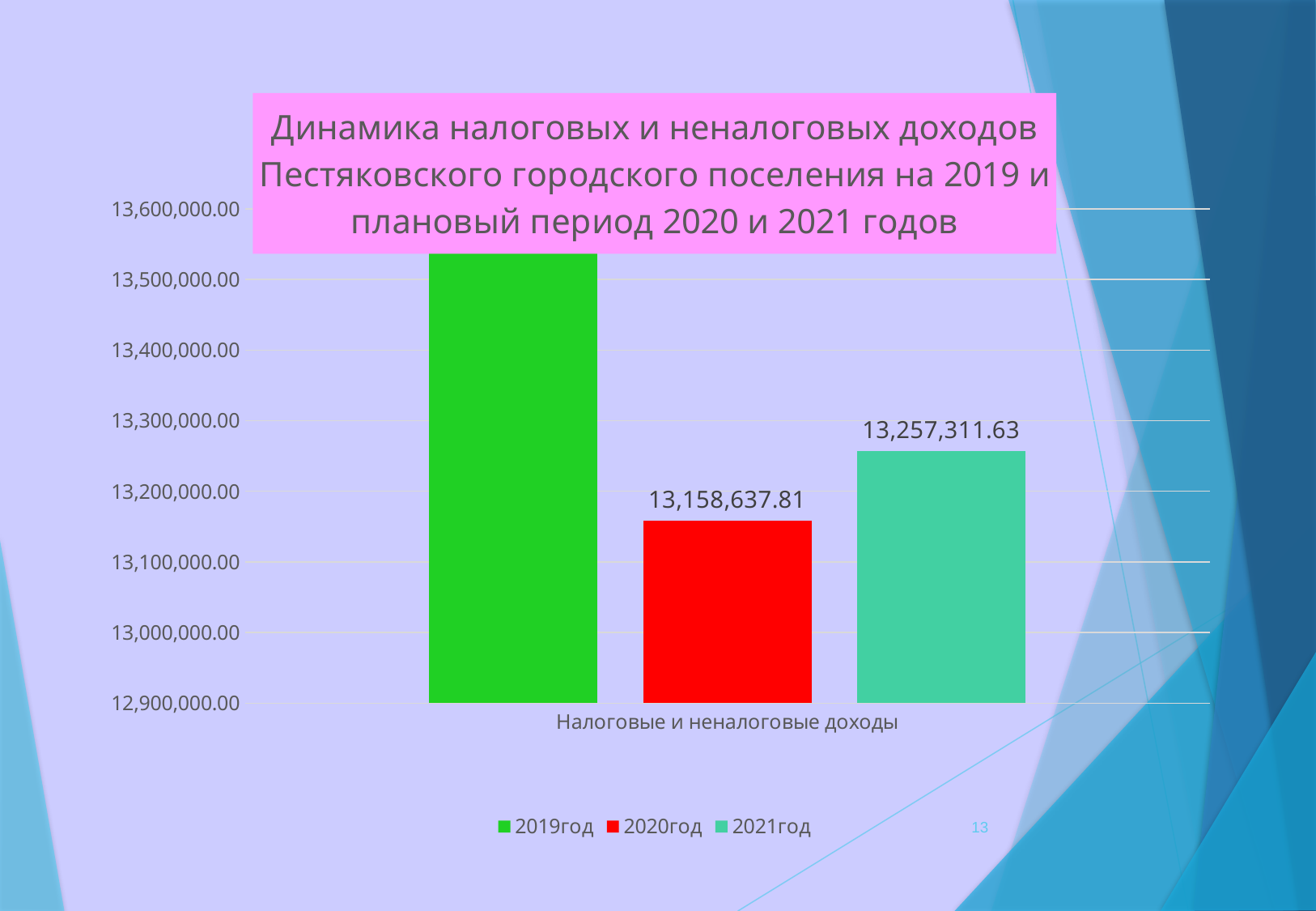
How many categories are shown on the x axis of the chart? 1 Which year has the highest bar in the chart? 2019год Which is larger, the value for 2020год or the value for 2021год? 2021год What colour is the bar for 2020год? red Which year has the lowest bar in the chart? 2020год Is the value for 2020год greater or less than 13,200,000.00? less What is the value for 2021год in the chart? 13,257,311.63 What kind of chart is shown on the slide? bar chart Is the value for 2019год greater or less than 13,500,000.00? greater How many series does the legend list? 3 What is the difference between the values for 2021год and 2020год? 98,673.82 What is the value for 2020год in the chart? 13,158,637.81